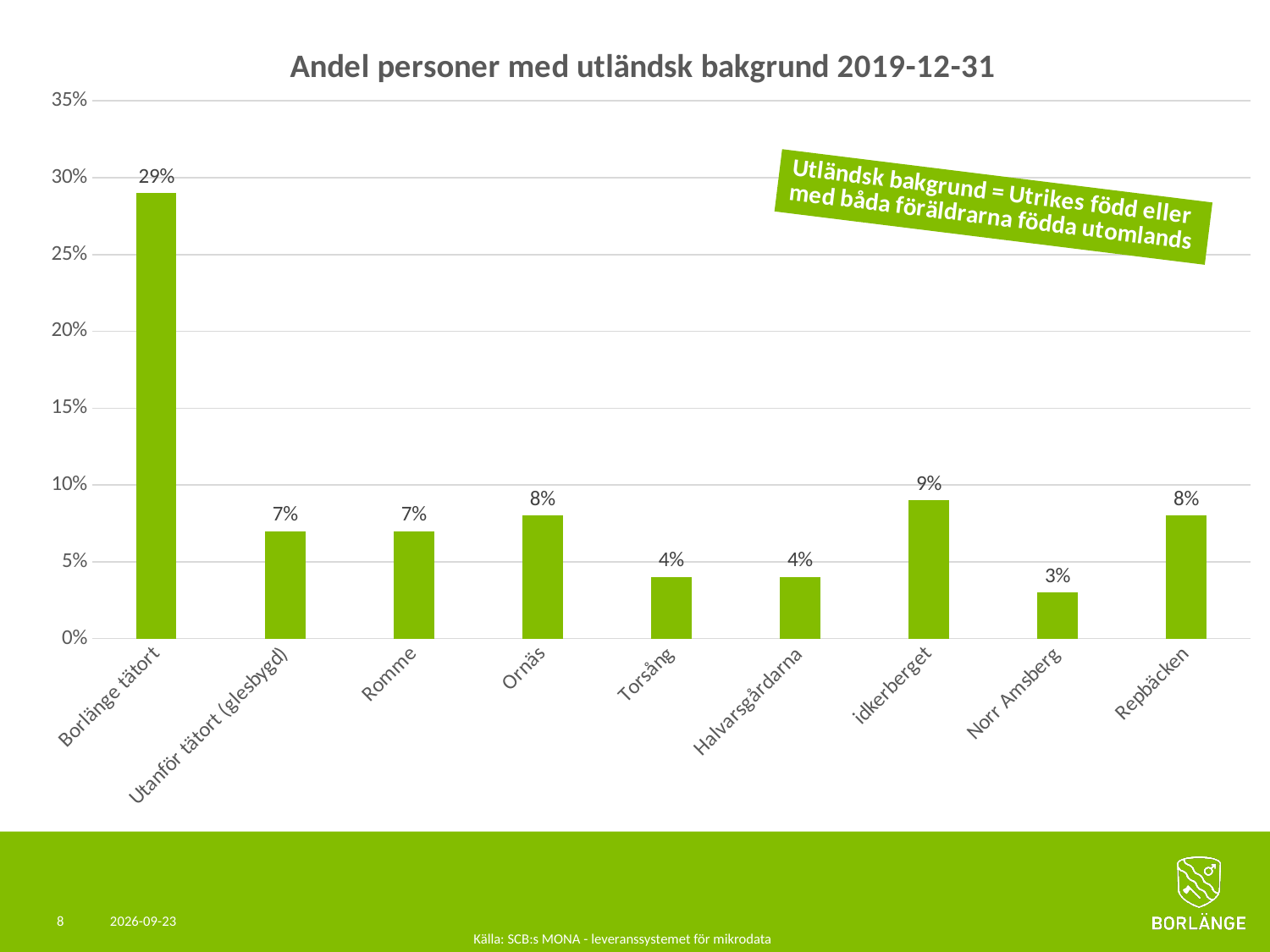
What is the value for Norr Amsberg? 3% What is the difference between the values for Ornäs and Norr Amsberg? 5% Which category has the lowest value? Norr Amsberg What is the value for Torsång? 4% What is the difference between the values for Borlänge tätort and Idkerberget? 20% Is the value for Borlänge tätort greater or less than 25%? greater Which category has the highest value? Borlänge tätort Which is larger, the value for Repbäcken or the value for Halvarsgårdarna? Repbäcken What is the value for Borlänge tätort? 29% How many categories are shown on the x axis? 9 What kind of chart is shown on the slide? Bar chart What is the value for Idkerberget? 9%